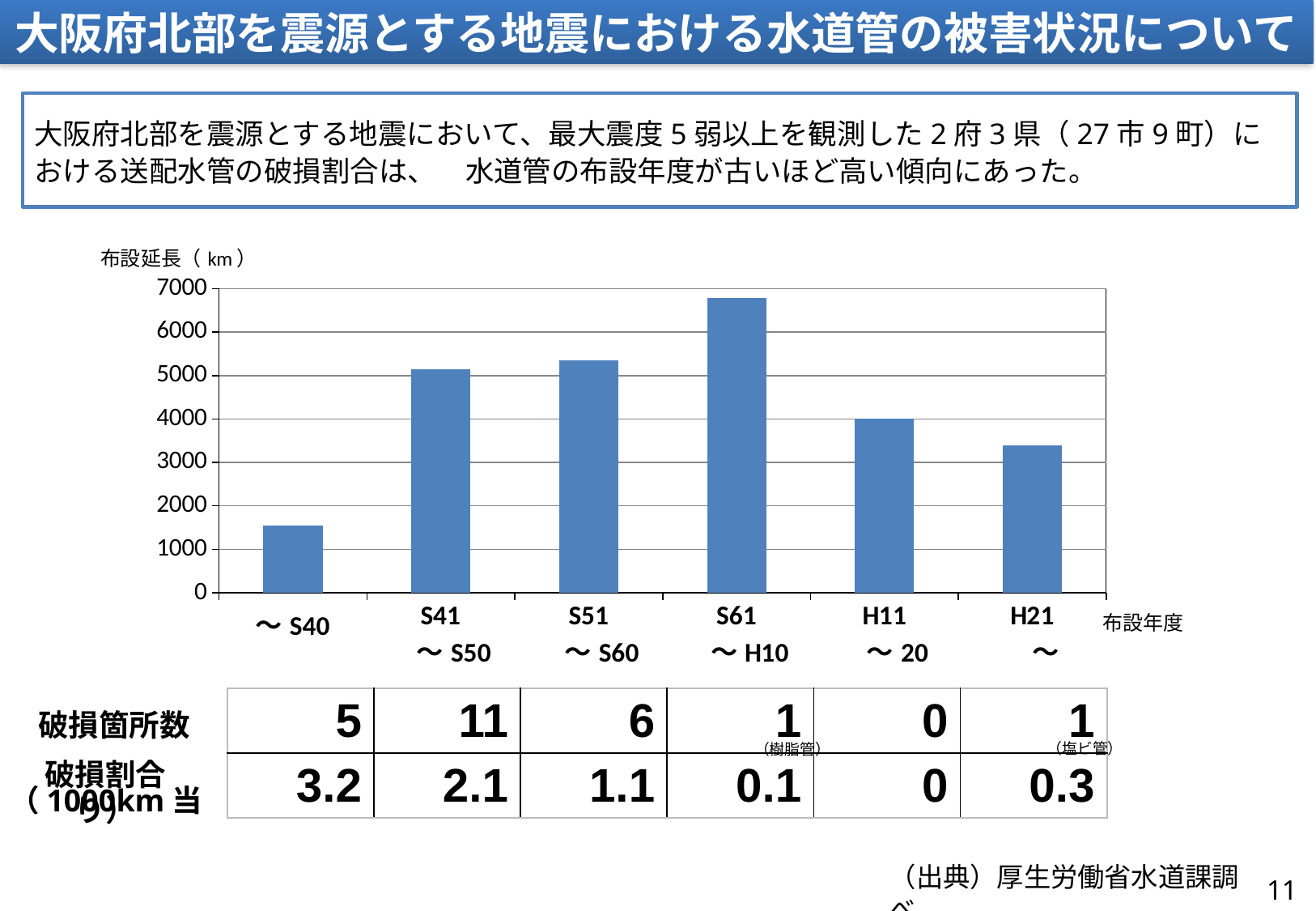
Is the 布設延長 for H21～ greater or less than 3000? greater Which 布設年度 category has the lowest 布設延長 in the chart? ～S40 How many categories (布設年度 periods) are plotted on the x axis of the chart? 6 Which has the larger 布設延長, ～S40 or H21～? H21～ What is the label and unit shown on the vertical axis of the chart? 布設延長（km） What kind of chart is shown on the slide? bar chart Which 布設年度 category has the highest 布設延長 in the chart? S61～H10 Which has the larger 布設延長, H11～20 or H21～? H11～20 Is the 布設延長 for S61～H10 greater or less than 6000? greater From S61～H10 onward to H21～, do the bar values rise or fall? fall Is the 布設延長 for S41～S50 greater or less than 4000? greater